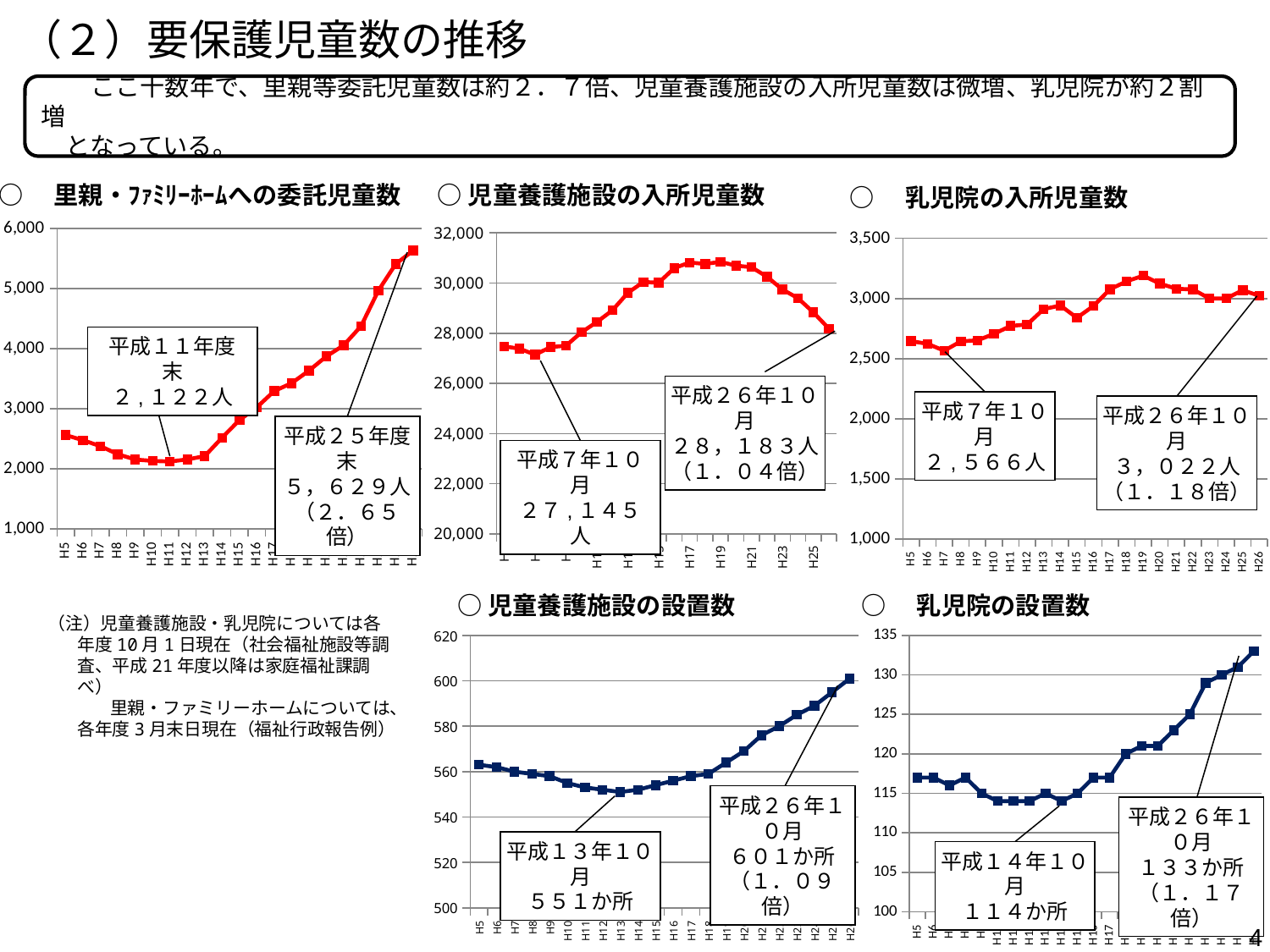
In the chart titled 児童養護施設の設置数, what value is labelled for 平成13年10月? 551か所 In the chart titled 児童養護施設の設置数, how much higher is the 平成26年10月 value than the 平成13年10月 value? 50か所 In the chart titled 乳児院の入所児童数, what is the difference between the 平成26年10月 value and the 平成7年10月 value? 456人 In the chart titled 里親・ファミリーホームへの委託児童数, what value is labelled for 平成25年度末? 5,629人 In the chart titled 乳児院の設置数, what value is labelled for 平成26年10月? 133か所 In the chart titled 里親・ファミリーホームへの委託児童数, what value is labelled for 平成11年度末? 2,122人 In the chart titled 児童養護施設の入所児童数, is the value for H19 greater or less than 30,000? greater In the chart titled 児童養護施設の入所児童数, what is the difference between the 平成26年10月 value and the 平成7年10月 value? 1,038人 What kind of chart is the chart titled 乳児院の設置数? line chart In the chart titled 乳児院の入所児童数, what value is labelled for 平成7年10月? 2,566人 In the chart titled 乳児院の設置数, which is larger, the 平成14年10月 value or the 平成26年10月 value? 平成26年10月 In the chart titled 児童養護施設の入所児童数, what value is labelled for 平成26年10月? 28,183人